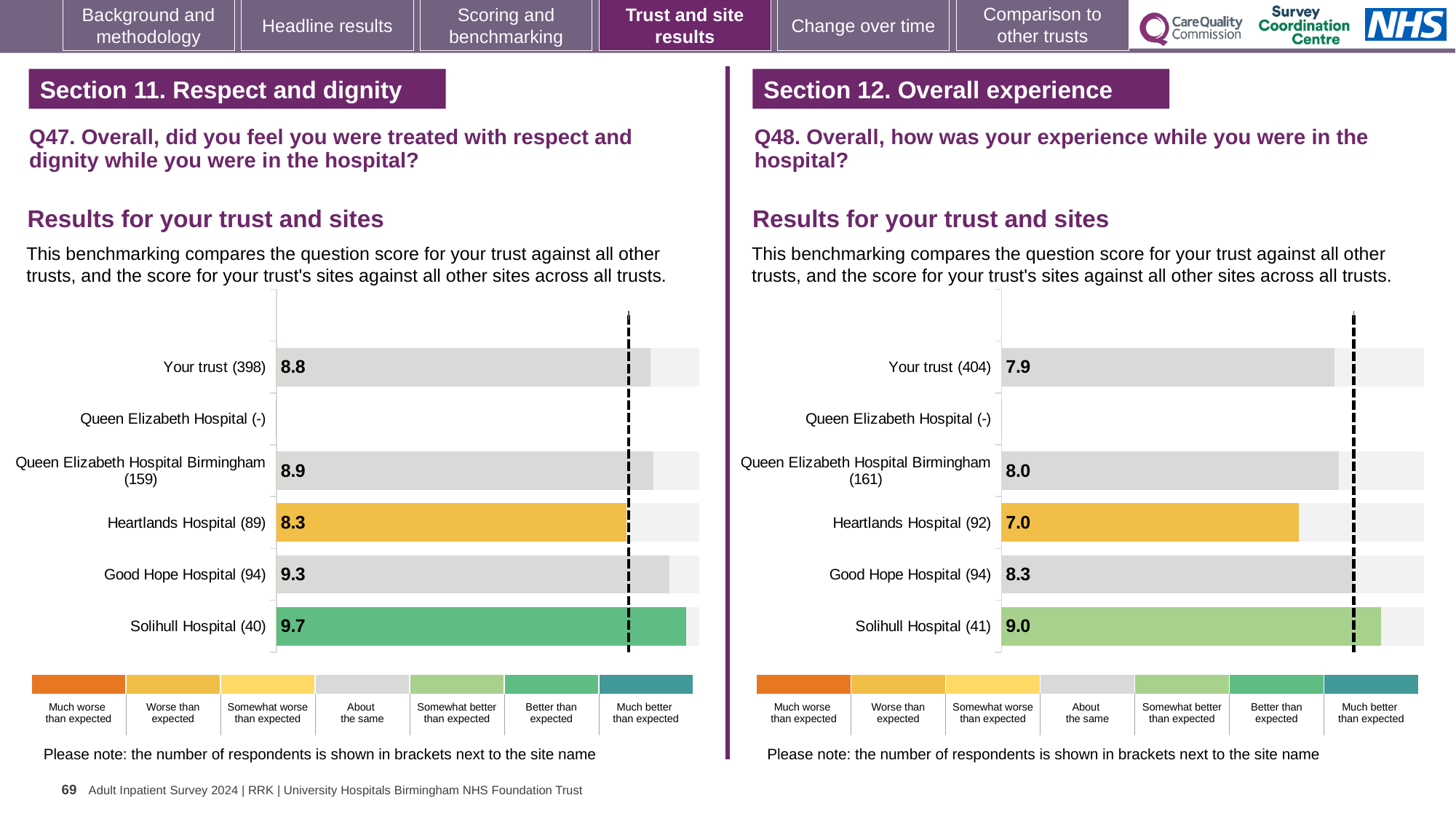
In the Q47 chart on the left, what is the score for Solihull Hospital (40)? 9.7 In the Q47 chart on the left, what colour is the bar for Solihull Hospital (40)? Green In the Q47 chart on the left, which site has the lowest score? Heartlands Hospital (89) In the Q47 chart on the left, which has the higher score: Queen Elizabeth Hospital Birmingham (159) or Your trust (398)? Queen Elizabeth Hospital Birmingham (159) In the Q47 chart on the left, what is the score for Your trust (398)? 8.8 In the Q48 chart on the right, what is the difference between the scores for Solihull Hospital (41) and Your trust (404)? 1.1 In the Q48 chart on the right, what is the score for Heartlands Hospital (92)? 7.0 In the Q48 chart on the right, how many site or trust labels are listed on the vertical axis? 6 In the Q48 chart on the right, what is the score for Good Hope Hospital (94)? 8.3 In the Q48 chart on the right, which site has the highest score? Solihull Hospital (41) What kind of chart is used for the Q48 results on the right? Bar chart In the Q47 chart on the left, what is the difference between the scores for Good Hope Hospital (94) and Heartlands Hospital (89)? 1.0